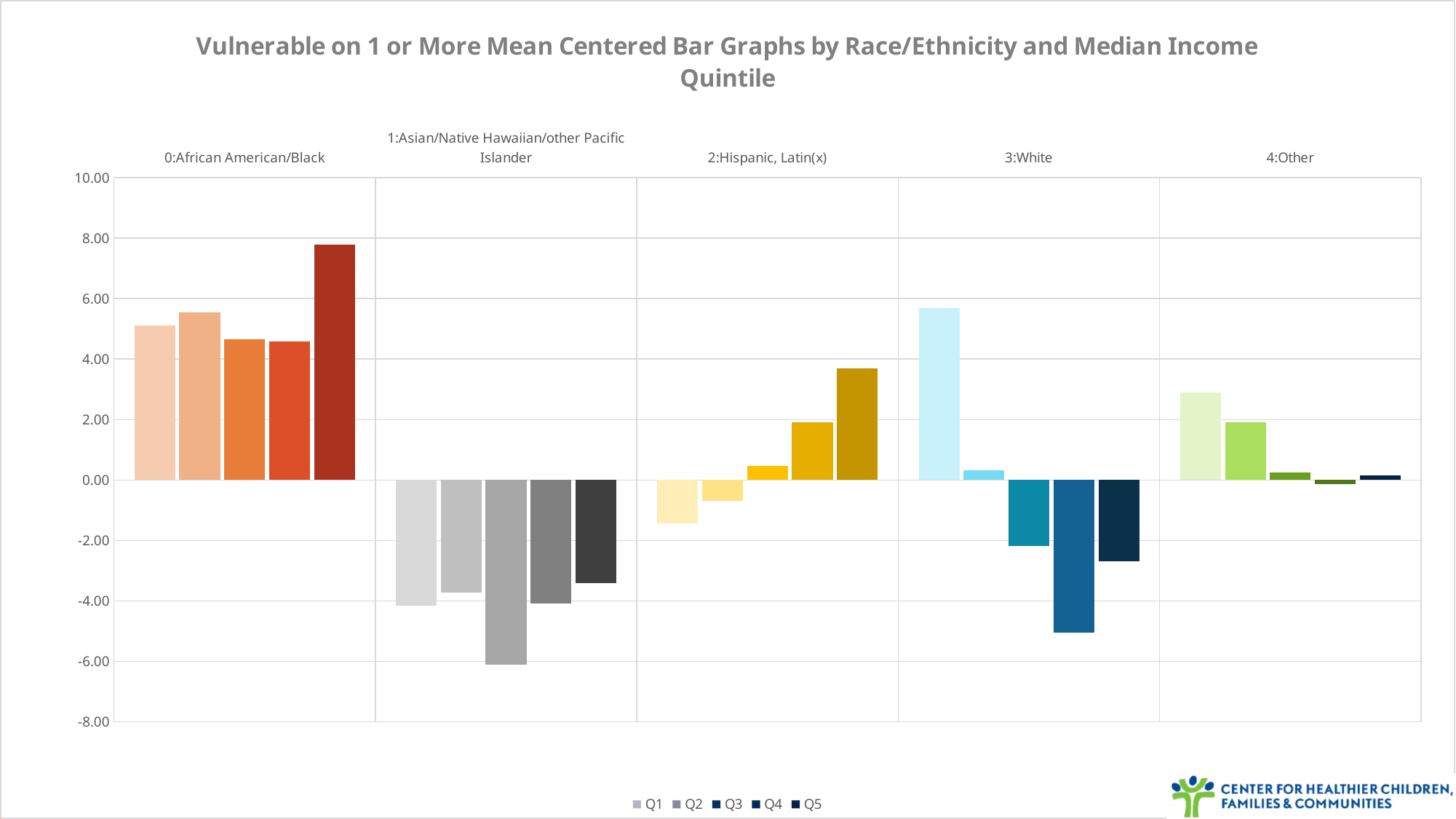
Is the Q4 value for 3:White greater or less than -4.00? less How many series does the legend list? 5 Is the Q3 value for 1:Asian/Native Hawaiian/other Pacific Islander greater or less than -4.00? less Do the values for 2:Hispanic, Latin(x) rise or fall from Q1 to Q5? rise Which quintile has the highest value within the 0:African American/Black group? Q5 How many race/ethnicity groups are shown along the x axis? 5 Which quintile has the lowest value within the 1:Asian/Native Hawaiian/other Pacific Islander group? Q3 Which quintile has the highest value within the 3:White group? Q1 Which is larger, the Q1 value for 3:White or the Q1 value for 4:Other? 3:White Is the Q5 value for 0:African American/Black greater or less than 6.00? greater Which race/ethnicity group has all five quintile bars below zero? 1:Asian/Native Hawaiian/other Pacific Islander What kind of chart is shown on the slide? bar chart